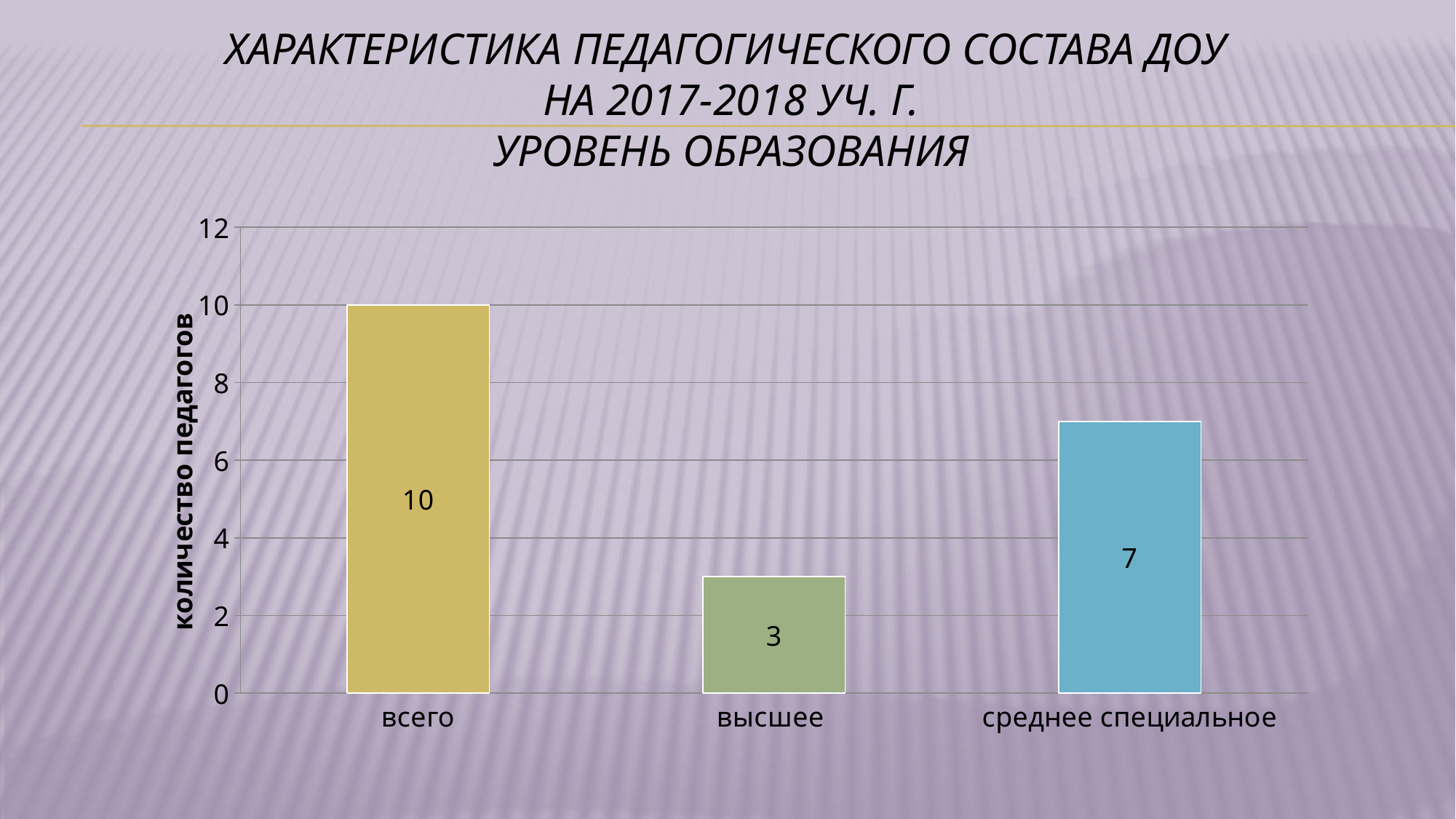
Which category has the lowest value? высшее What is the value for "всего"? 10 What kind of chart is shown on the slide? bar chart What is the difference between the values for "среднее специальное" and "высшее"? 4 How many categories are shown on the x axis? 3 What is the value for "среднее специальное"? 7 Is the value for "среднее специальное" greater or less than 6? greater Which is larger, the value for "высшее" or the value for "среднее специальное"? среднее специальное What is the difference between the values for "всего" and "среднее специальное"? 3 What is the value for "высшее"? 3 Which category has the highest value? всего What is the label of the vertical axis? количество педагогов